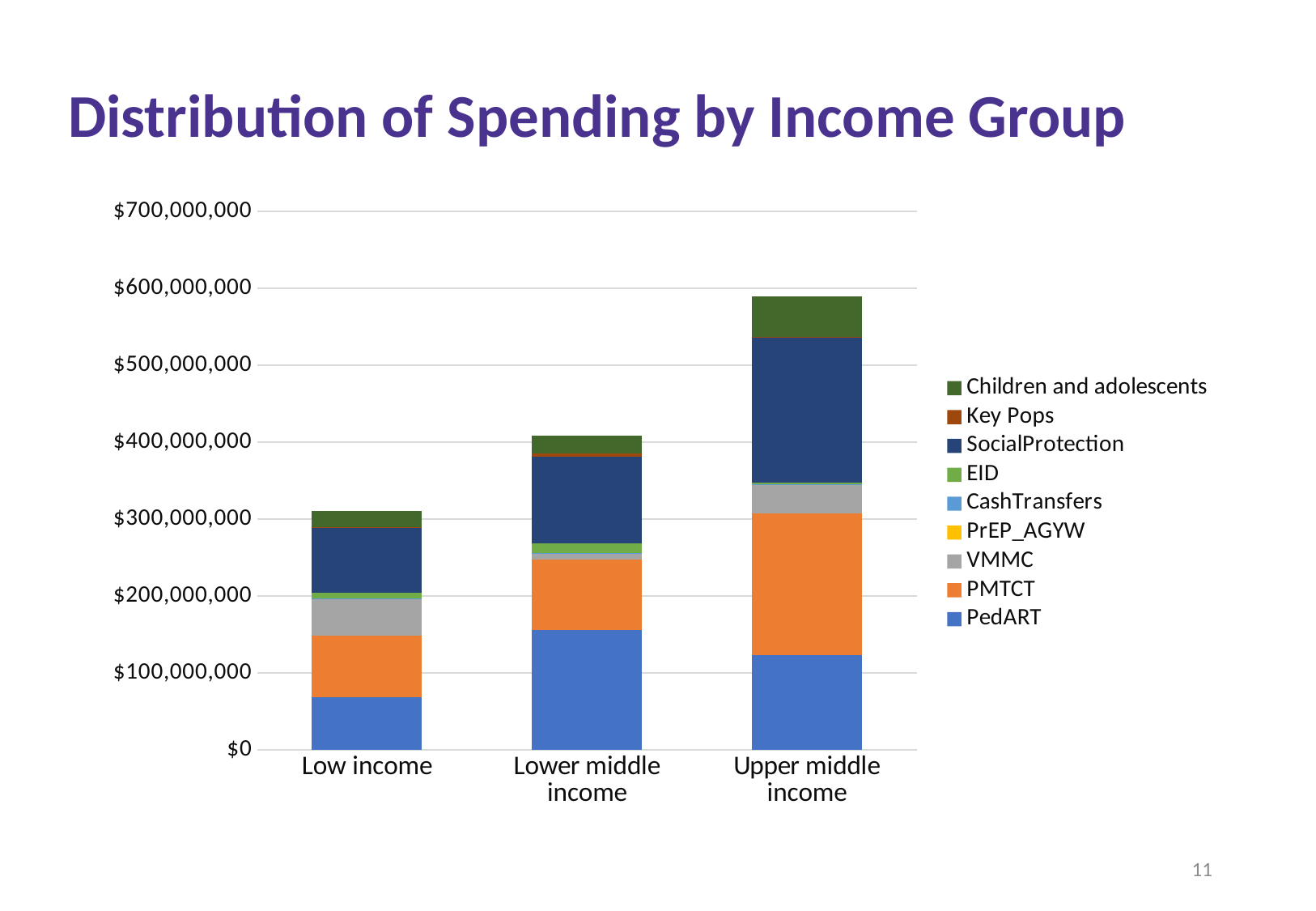
What is the title of the chart? Distribution of Spending by Income Group How many income groups are shown on the x axis? 3 Which series appears at the bottom of each stacked bar? PedART How many series does the legend list? 9 Is the total spending for Low income greater or less than $400,000,000? less What kind of chart is shown on the slide? Stacked bar chart Is the PedART value for Low income greater or less than $100,000,000? less Which income group has the larger PedART segment, Lower middle income or Upper middle income? Lower middle income Do the total bar heights rise or fall from Low income to Upper middle income? Rise Which income group has the highest total spending? Upper middle income Which income group has the lowest total spending? Low income Is the total spending for Upper middle income greater or less than $500,000,000? greater